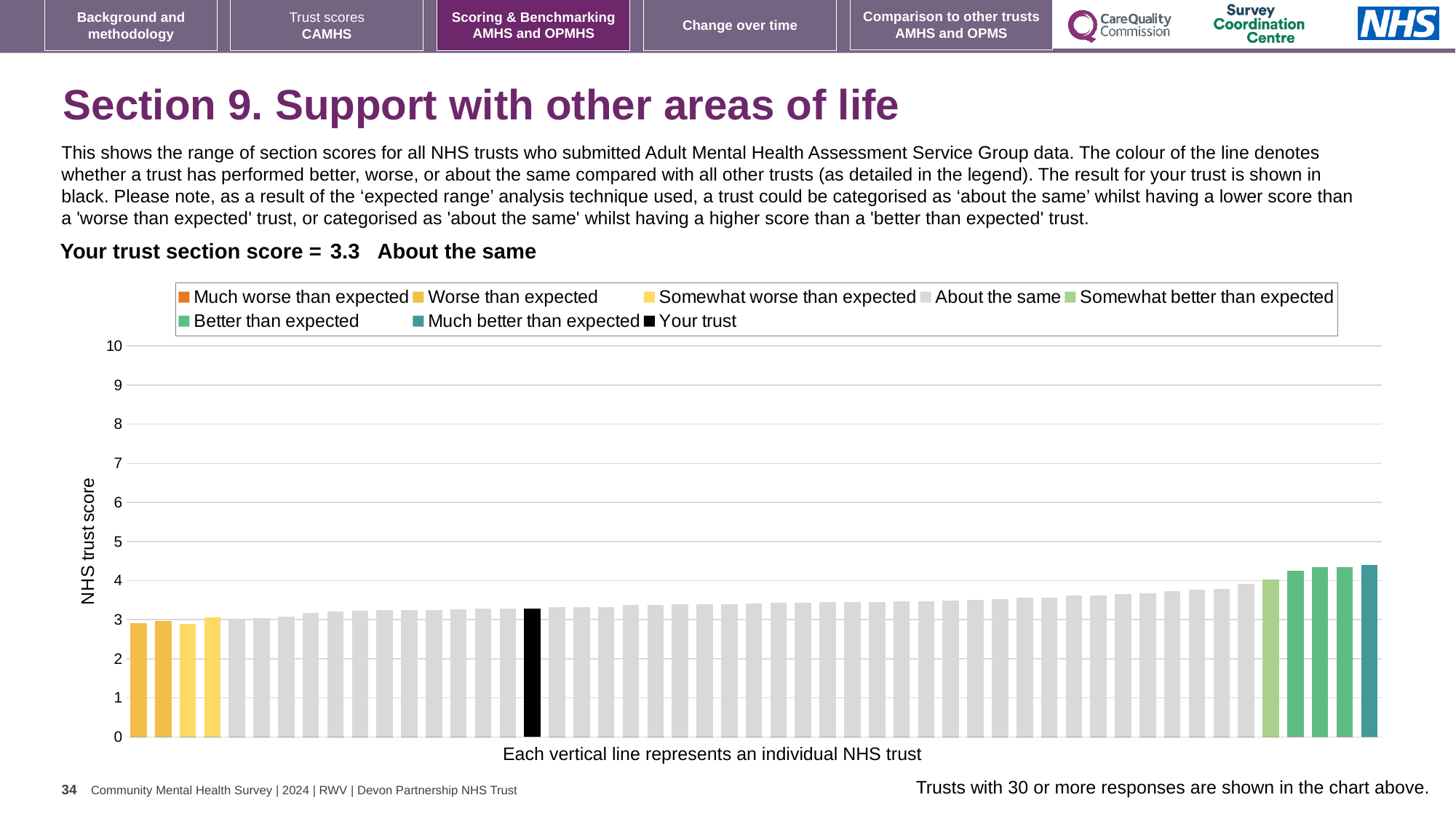
Do the bar values rise or fall from left to right across the chart? rise What is the highest value shown on the vertical axis of the chart? 10 Is the value of the tallest bar in the chart greater or less than 5? less How many entries does the chart legend list? 8 Is the value of the black 'Your trust' bar greater or less than 3? greater What is the label on the vertical axis of the chart? NHS trust score How is your trust's section score categorised compared with other trusts? About the same According to the text below the chart, what does each vertical line represent? an individual NHS trust What kind of chart is shown on the slide? bar chart Are the bars at the right end of the chart higher or lower than the bars at the left end? higher Is the value of the tallest bar in the chart greater or less than 4? greater What is the section score for your trust shown on the slide? 3.3